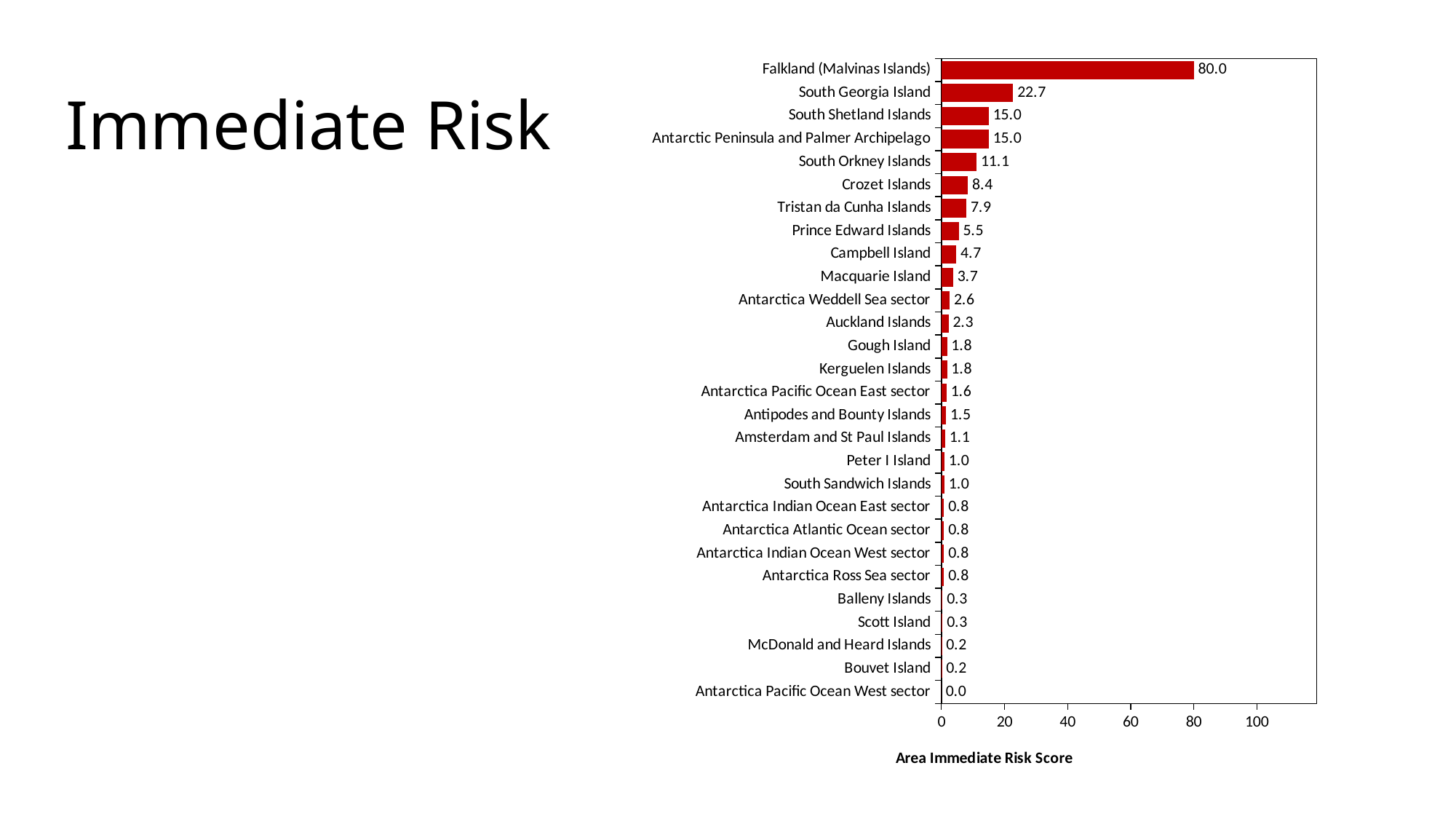
How many areas are shown in the chart? 28 What type of chart is shown on the slide? bar chart What is the Area Immediate Risk Score for Macquarie Island? 3.7 Which area has the highest Area Immediate Risk Score? Falkland (Malvinas Islands) Which has a higher Area Immediate Risk Score, Tristan da Cunha Islands or Prince Edward Islands? Tristan da Cunha Islands What is the Area Immediate Risk Score for Falkland (Malvinas Islands)? 80.0 What is the Area Immediate Risk Score for South Georgia Island? 22.7 What is the difference between the Area Immediate Risk Scores of South Orkney Islands and Crozet Islands? 2.7 Is the Area Immediate Risk Score for South Georgia Island greater or less than 20? greater What is the difference between the Area Immediate Risk Scores of Falkland (Malvinas Islands) and South Georgia Island? 57.3 What is the Area Immediate Risk Score for Crozet Islands? 8.4 Which area has the lowest Area Immediate Risk Score? Antarctica Pacific Ocean West sector